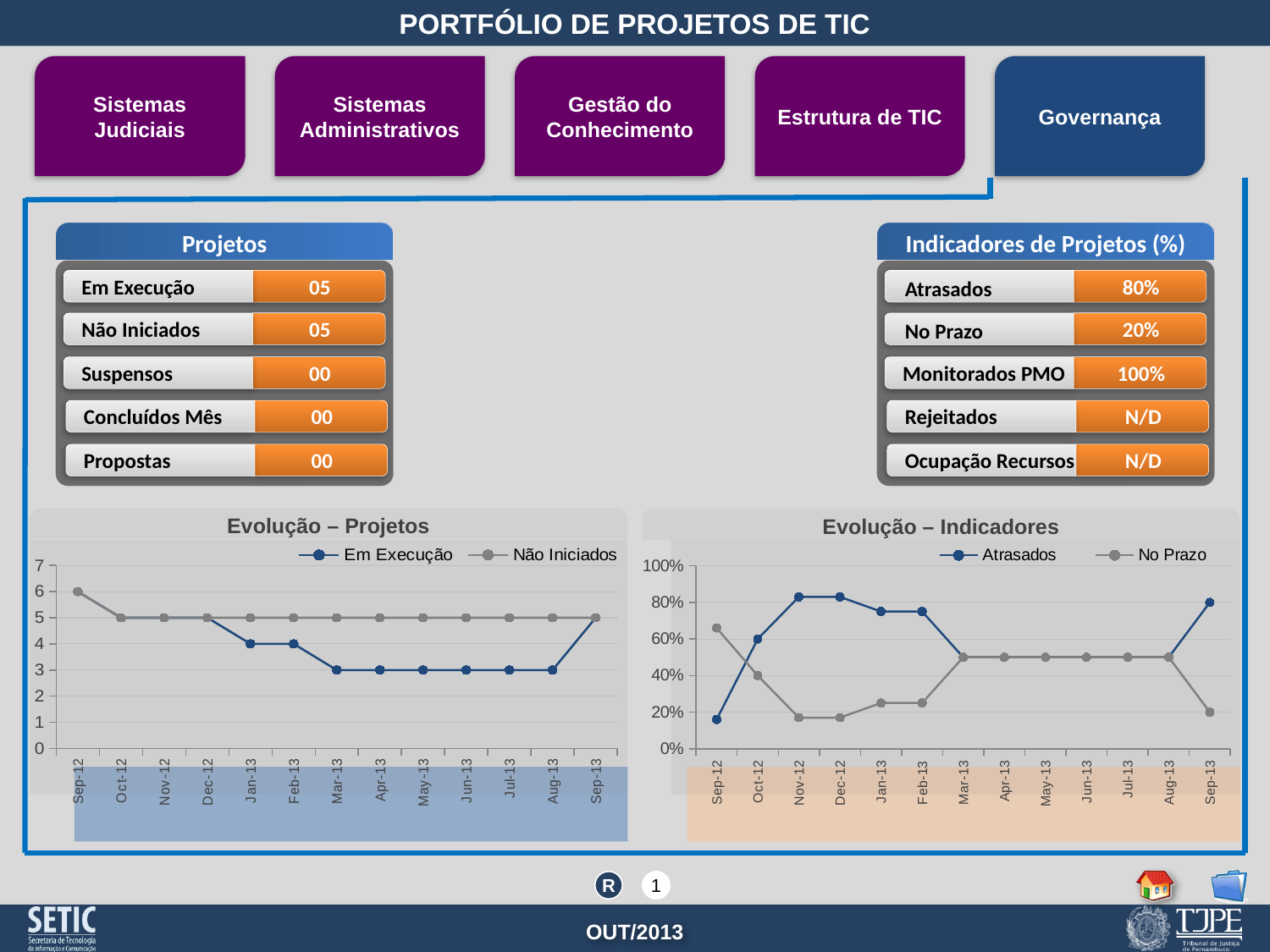
In the 'Evolução – Projetos' chart, what is the value of Em Execução in Sep-12? 6 In the 'Evolução – Indicadores' chart, what is the value of Atrasados in Sep-13? 80% In the 'Evolução – Projetos' chart, what is the difference between Não Iniciados and Em Execução in Jan-13? 1 In the 'Evolução – Indicadores' chart, which series is higher in Sep-12, Atrasados or No Prazo? No Prazo In the 'Evolução – Projetos' chart, how many months are plotted along the x axis? 13 In the 'Evolução – Indicadores' chart, what is the value of No Prazo in Oct-12? 40% In the 'Evolução – Projetos' chart, what is the value of Em Execução in Mar-13? 3 In the 'Evolução – Projetos' chart, how many series does the legend list? 2 In the 'Evolução – Indicadores' chart, is the value for Atrasados in Nov-12 greater or less than 60%? greater What type of chart is the 'Evolução – Projetos' chart? line chart In the 'Evolução – Projetos' chart, what is the value of Não Iniciados in Sep-13? 5 In the 'Evolução – Projetos' chart, which series is higher in Jun-13, Em Execução or Não Iniciados? Não Iniciados